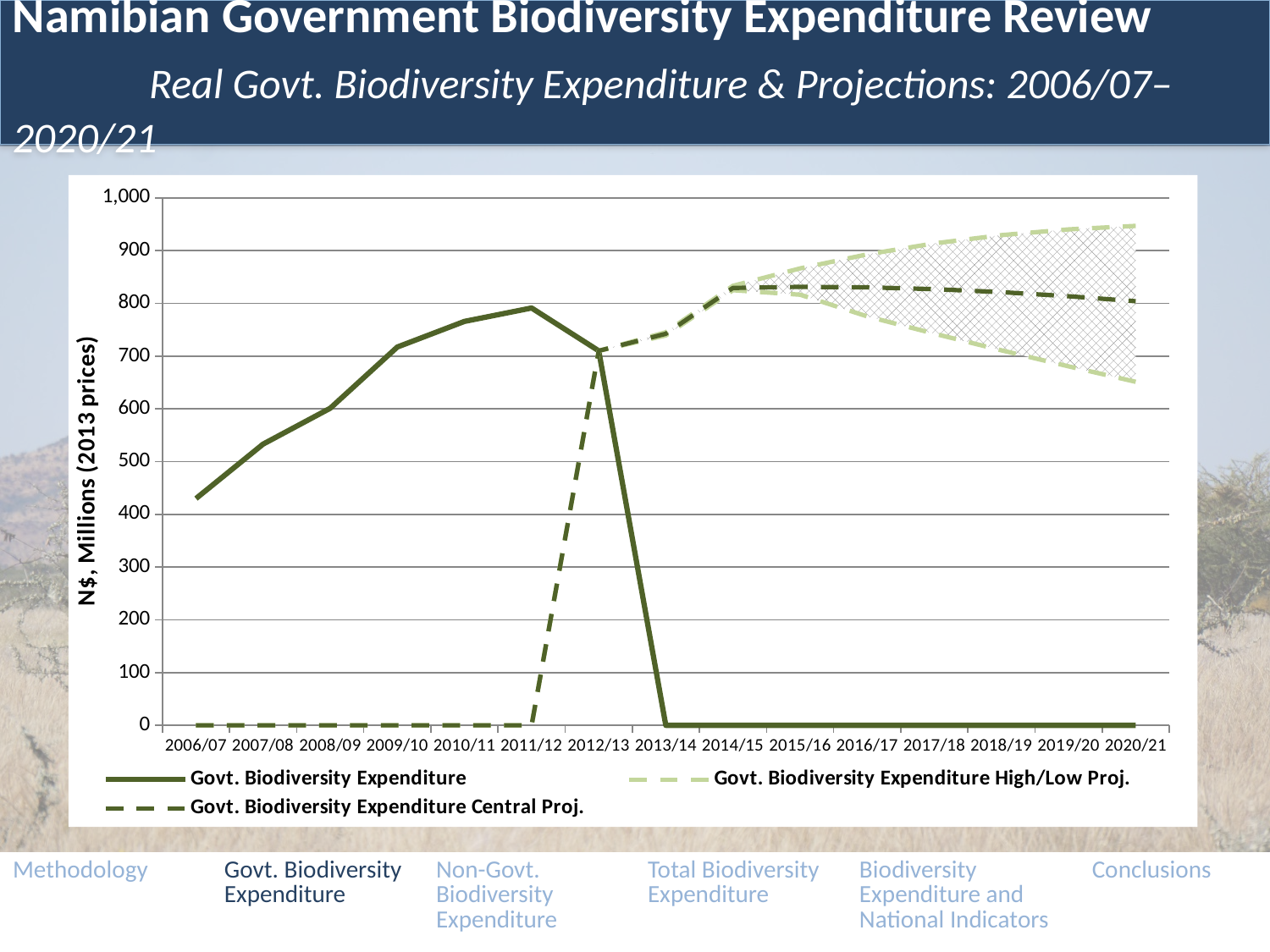
Does the Govt. Biodiversity Expenditure line rise or fall from 2006/07 to 2011/12? rise What kind of chart is shown on the slide? line chart Is the Govt. Biodiversity Expenditure High/Low Proj. lower value for 2020/21 greater or less than 700? less How many series does the legend list? 3 Which year has the highest Govt. Biodiversity Expenditure (solid line)? 2011/12 How many fiscal years are shown along the x axis? 15 Which is larger for Govt. Biodiversity Expenditure: 2006/07 or 2007/08? 2007/08 Is the Govt. Biodiversity Expenditure value for 2006/07 greater or less than 500? less Is the Govt. Biodiversity Expenditure value for 2012/13 greater or less than 800? less What is the label of the vertical axis? N$, Millions (2013 prices)